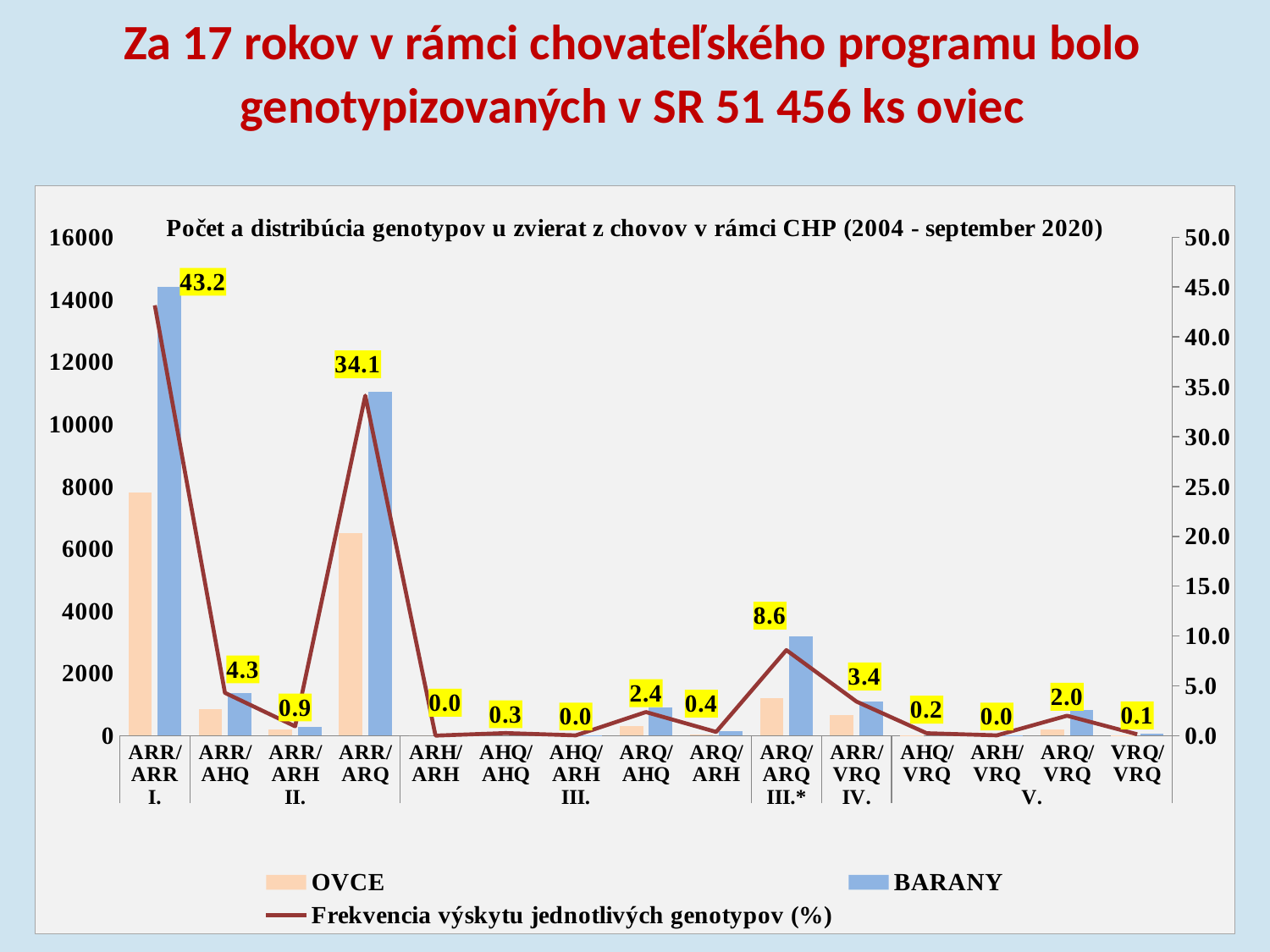
What is the frequency (%) value labelled for the ARQ/ARQ genotype? 8.6 What is the frequency (%) value labelled for the ARR/ARR genotype? 43.2 Which has the larger frequency value, ARR/AHQ or ARR/VRQ? ARR/AHQ How many genotype categories are shown on the x axis? 15 What is the frequency (%) value labelled for the ARQ/AHQ genotype? 2.4 What kind of chart is this? Combined bar and line chart What is the difference between the frequency values for ARR/ARR and ARR/ARQ? 9.1 Is the BARANY bar for ARR/ARR greater or less than 12000? greater Which genotype has the highest frequency (%) value on the line? ARR/ARR What is the frequency (%) value labelled for the ARR/ARQ genotype? 34.1 Is the BARANY bar for ARQ/ARQ greater or less than 2000? greater How many series does the legend list? 3